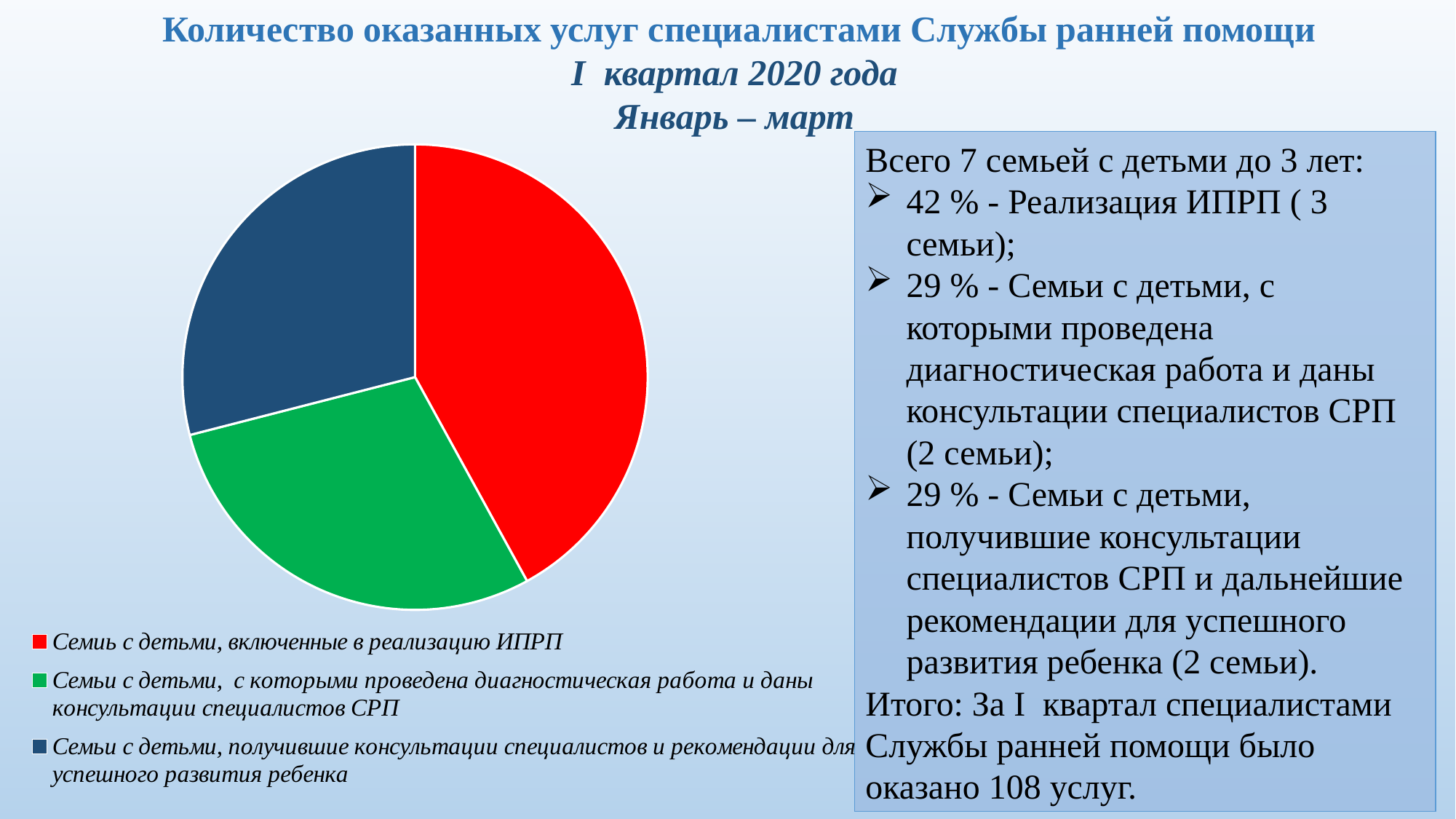
How many slices does the pie chart have? 3 How many families are included in the implementation of ИПРП according to the slide? 3 семьи What is the difference in percentage points between the share for реализация ИПРП (42 %) and the share for диагностическая работа (29 %)? 13 percentage points What type of chart is shown on the slide? Pie chart What share of the pie does the slice for families with whom diagnostic work was carried out and consultations of СРП specialists were given represent? 29 % Which category has the largest slice in the pie chart? Семьи с детьми, включенные в реализацию ИПРП What share of the pie does the slice for families included in the implementation of ИПРП represent? 42 % How many entries does the legend of the pie chart list? 3 Which slice is larger: the red slice (реализация ИПРП) or the green slice (диагностическая работа)? The red slice (реализация ИПРП) What colour is the slice for families included in the implementation of ИПРП? Red Which period does the chart title refer to? I квартал 2020 года, Январь – март What is the total number of families with children under 3 represented in the pie chart? 7